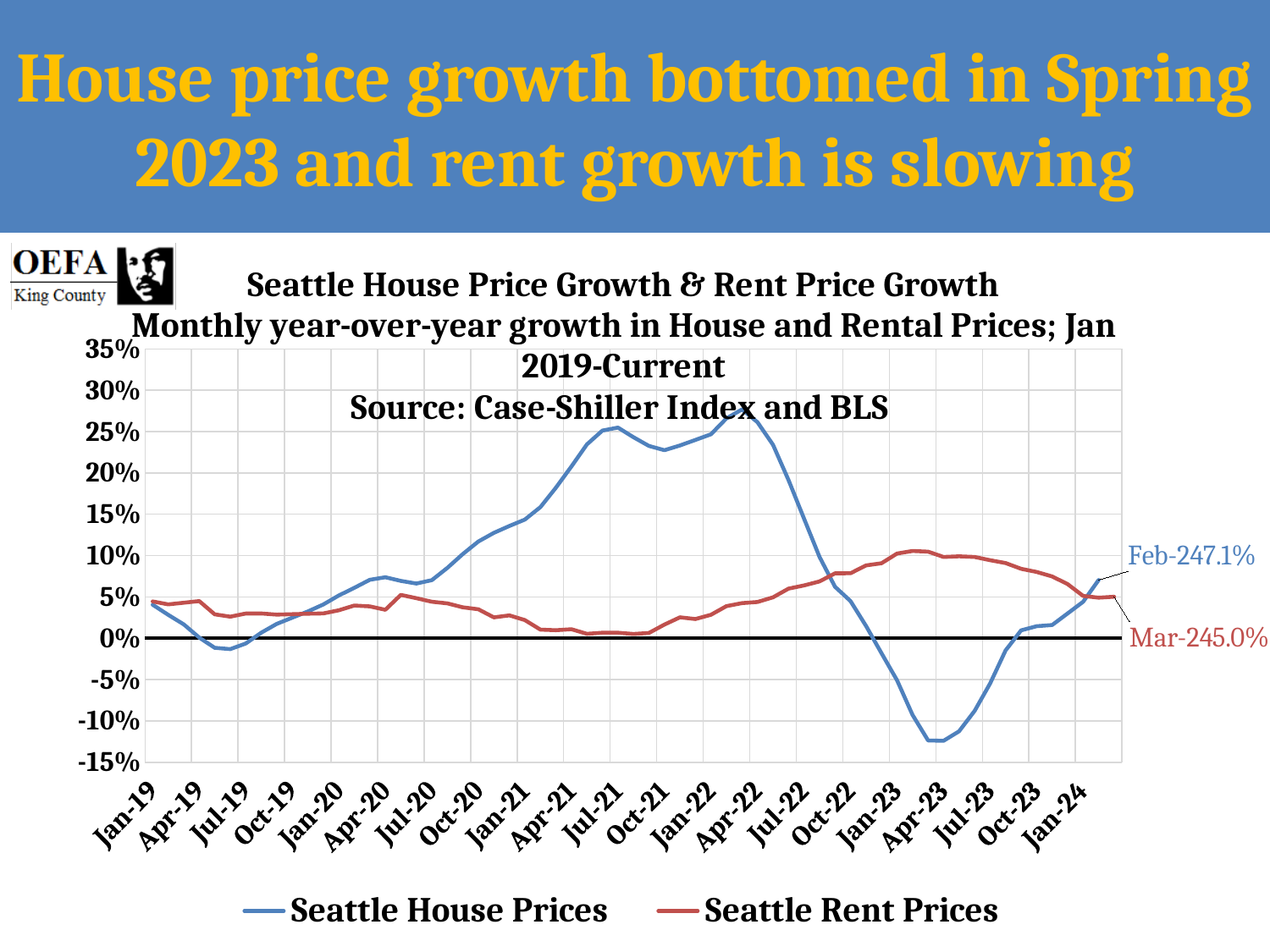
Is the peak value for Seattle House Prices around Apr-22 greater or less than 25%? greater What kind of chart is shown on the slide? line chart Is the value for Seattle House Prices at Apr-23 greater or less than -10%? less Is the value for Seattle Rent Prices at Jul-21 greater or less than 5%? less At Apr-23, which series has the higher value, Seattle House Prices or Seattle Rent Prices? Seattle Rent Prices How many series does the legend list? 2 At Jan-22, which series has the higher value, Seattle House Prices or Seattle Rent Prices? Seattle House Prices Does the Seattle Rent Prices line rise or fall between Apr-23 and Jan-24? fall What are the two series named in the legend? Seattle House Prices and Seattle Rent Prices Does the Seattle House Prices line rise or fall between Apr-23 and Jan-24? rise Which series reaches the higher peak value over the period shown, Seattle House Prices or Seattle Rent Prices? Seattle House Prices